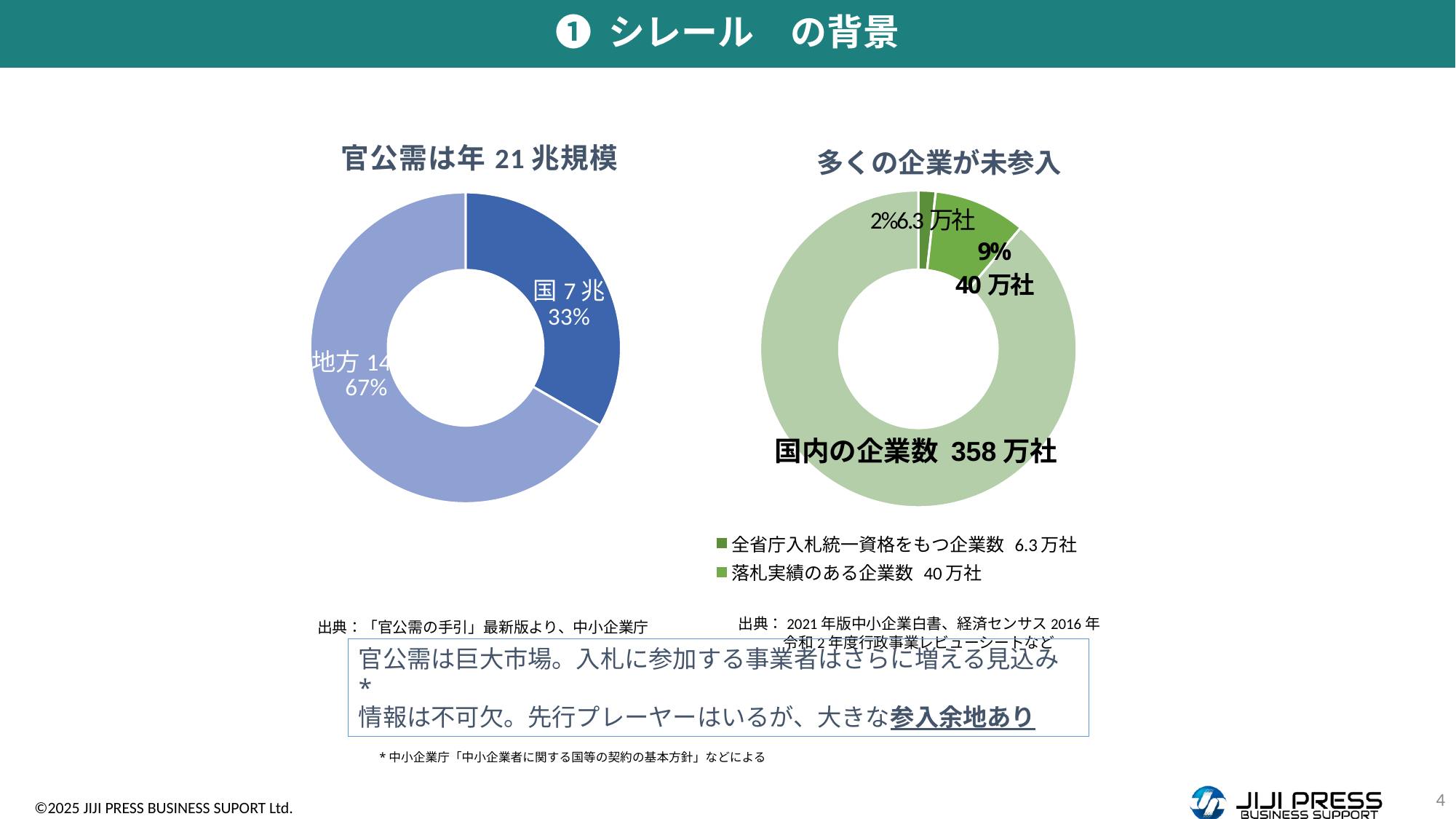
In the chart titled 多くの企業が未参入, what percentage is labelled for the segment of 6.3万社? 2% In the chart titled 多くの企業が未参入, what percentage is labelled for the segment of 40万社? 9% In the chart titled 官公需は年21兆規模, what value in 兆 is shown for 国? 7兆 In the chart titled 官公需は年21兆規模, how many segments does the donut have? 2 In the chart titled 多くの企業が未参入, what total number of domestic companies (国内の企業数) is shown? 358万社 In the chart titled 多くの企業が未参入, how many entries does the legend list? 2 What kind of chart is the chart titled 官公需は年21兆規模? donut chart In the chart titled 多くの企業が未参入, what is the number of companies shown for 落札実績のある企業数? 40万社 In the chart titled 官公需は年21兆規模, which segment is larger, 国 or 地方? 地方 In the chart titled 多くの企業が未参入, what is the number of companies shown for 全省庁入札統一資格をもつ企業数? 6.3万社 In the chart titled 官公需は年21兆規模, what percentage share is labelled for 国? 33%